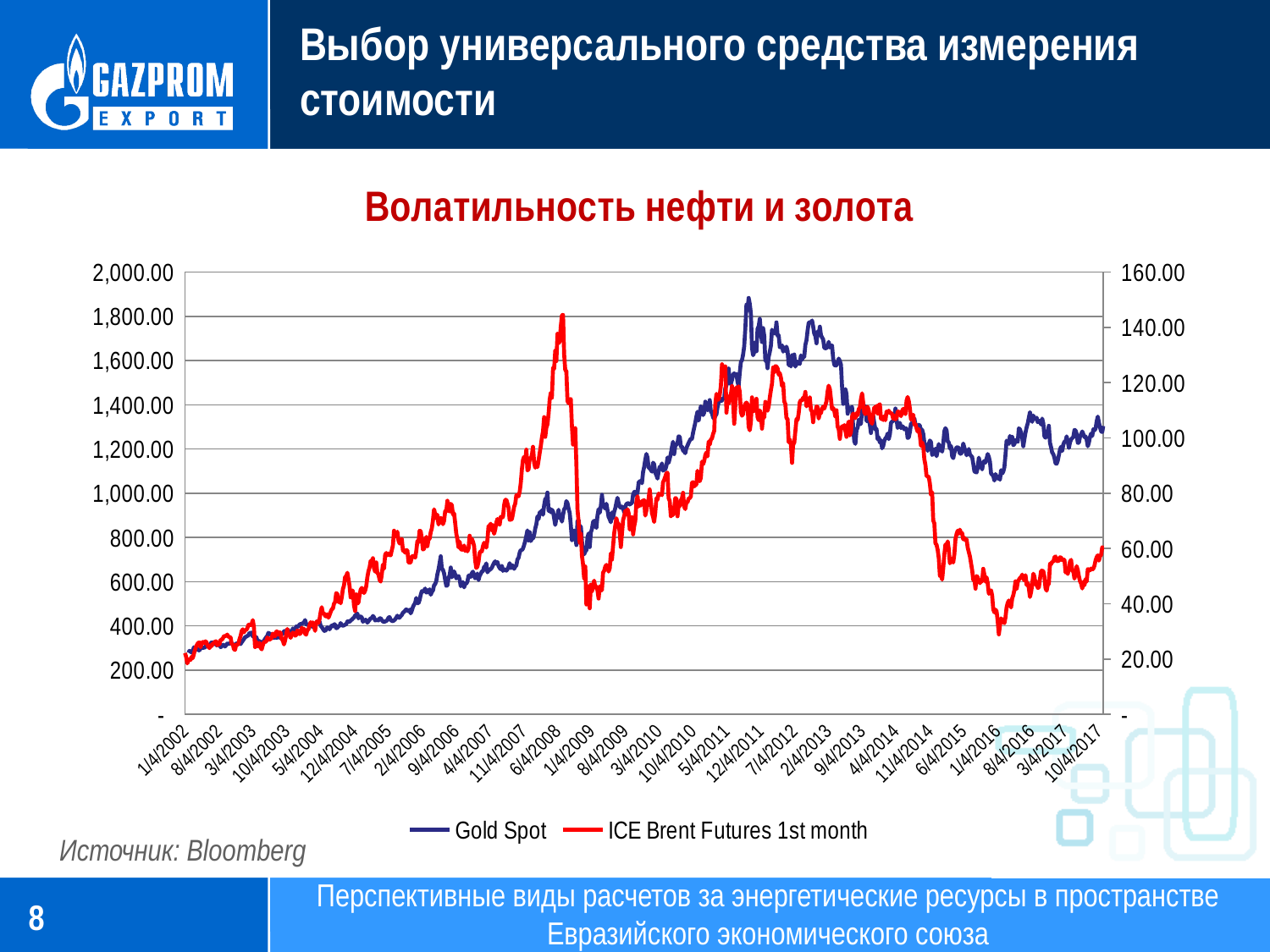
What is the highest tick value shown on the right-hand axis? 160.00 Is the Gold Spot value at 10/4/2017 greater or less than 1,000.00 on the left axis? greater Is the ICE Brent Futures 1st month value at its low point in early 2016 greater or less than 40.00 on the right axis? less What colour is the ICE Brent Futures 1st month line? red Is the peak ICE Brent Futures 1st month value reached in 2008 greater or less than 120.00 on the right axis? greater What are the two series named in the legend? Gold Spot and ICE Brent Futures 1st month Does the ICE Brent Futures 1st month line rise or fall between mid-2014 and early 2016? fall What kind of chart is shown on the slide? line chart Does the Gold Spot line rise or fall between 1/4/2002 and 2011? rise How many series does the legend list? 2